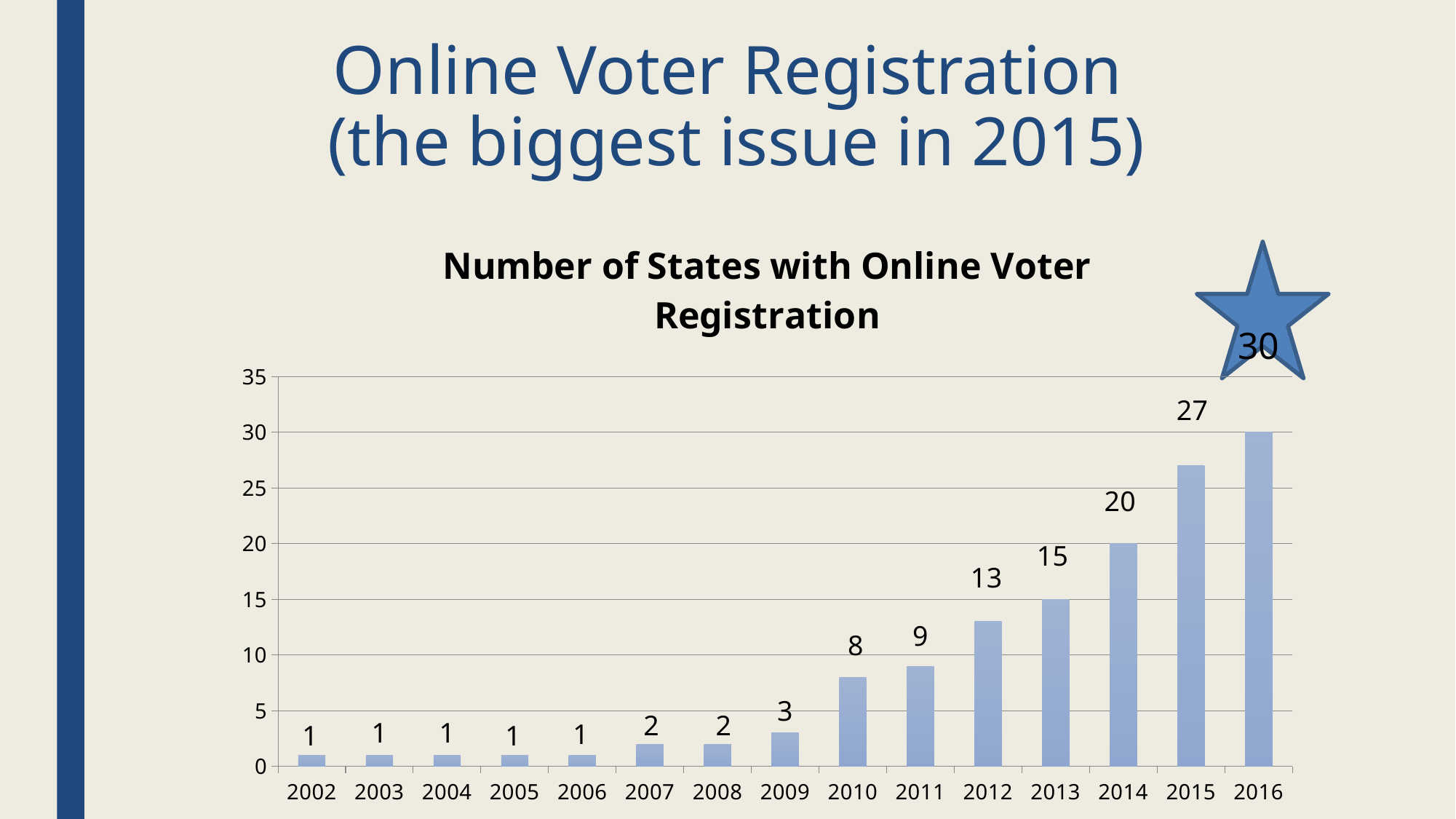
Is the value for 2015 greater or less than 25? greater What is the title of the chart? Number of States with Online Voter Registration How many years are shown on the x axis of the chart? 15 What is the value shown for 2009? 3 What is the value shown for 2010? 8 Which year has the highest number of states with online voter registration? 2016 What is the number of states with online voter registration in 2014? 20 What is the difference between the values for 2014 and 2012? 7 What is the difference between the values for 2016 and 2015? 3 What kind of chart is shown on the slide? Bar chart Which year has the larger value, 2011 or 2013? 2013 Do the values rise or fall from 2002 to 2016? Rise